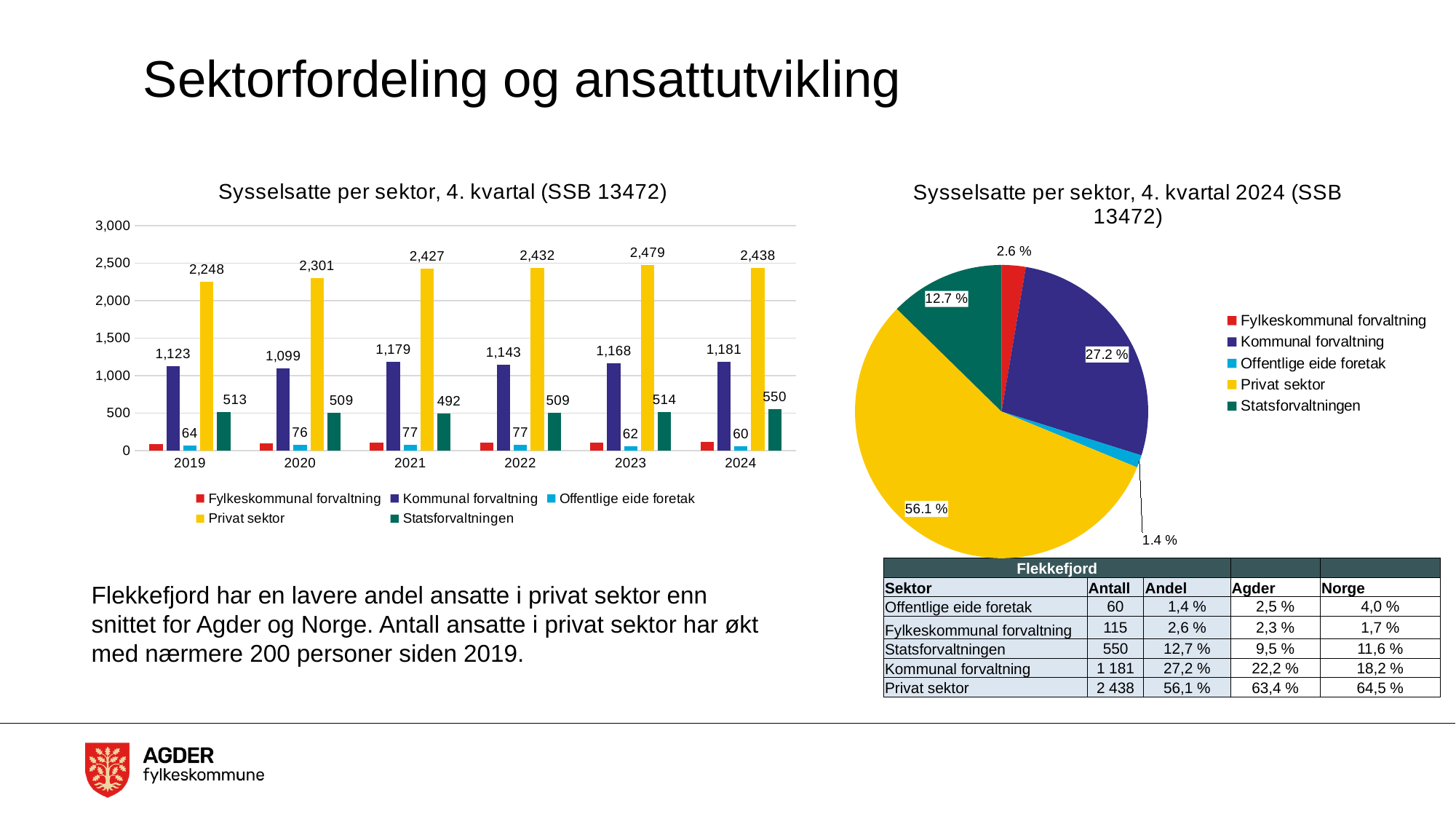
In the bar chart 'Sysselsatte per sektor, 4. kvartal (SSB 13472)', what is the value for Statsforvaltningen in 2024? 550 In the bar chart 'Sysselsatte per sektor, 4. kvartal (SSB 13472)', is the value for Fylkeskommunal forvaltning in 2024 greater or less than 500? less How many years are shown on the x axis of the bar chart 'Sysselsatte per sektor, 4. kvartal (SSB 13472)'? 6 In the bar chart 'Sysselsatte per sektor, 4. kvartal (SSB 13472)', which is larger: Statsforvaltningen in 2021 or Statsforvaltningen in 2022? 2022 In the bar chart 'Sysselsatte per sektor, 4. kvartal (SSB 13472)', in which year is the Offentlige eide foretak value lowest? 2024 In the bar chart 'Sysselsatte per sektor, 4. kvartal (SSB 13472)', what is the difference between the Privat sektor values in 2024 and 2019? 190 How many series does the legend of the bar chart 'Sysselsatte per sektor, 4. kvartal (SSB 13472)' list? 5 In the pie chart 'Sysselsatte per sektor, 4. kvartal 2024 (SSB 13472)', which sector has the smallest slice? Offentlige eide foretak In the bar chart 'Sysselsatte per sektor, 4. kvartal (SSB 13472)', in which year is the Privat sektor value highest? 2023 In the pie chart 'Sysselsatte per sektor, 4. kvartal 2024 (SSB 13472)', what share does Privat sektor have? 56.1 % In the bar chart 'Sysselsatte per sektor, 4. kvartal (SSB 13472)', what is the value for Kommunal forvaltning in 2021? 1,179 In the bar chart 'Sysselsatte per sektor, 4. kvartal (SSB 13472)', what is the value for Privat sektor in 2024? 2,438